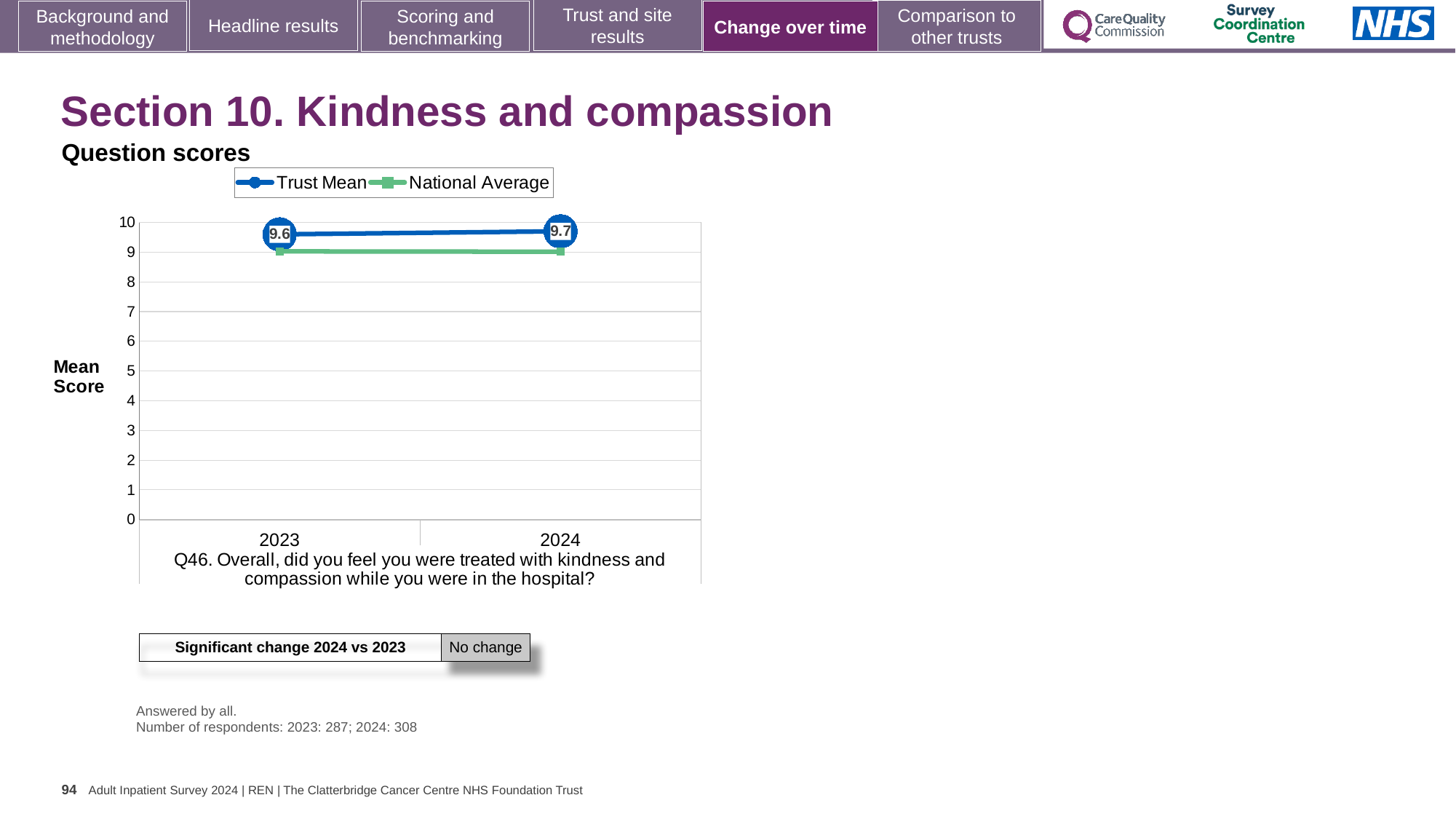
By how much did the Trust Mean change from 2023 to 2024? 0.1 Is the National Average value for 2023 greater or less than 8? greater Is the National Average value for 2024 greater or less than 10? less What is the Trust Mean score for 2024? 9.7 What is the label on the y axis of the chart? Mean Score Which year has the higher Trust Mean score, 2023 or 2024? 2024 How many series does the chart legend list? 2 Does the Trust Mean rise or fall from 2023 to 2024? Rise What kind of chart is shown on the slide? Line chart What is the Trust Mean score for 2023? 9.6 In 2024, which series is higher, Trust Mean or National Average? Trust Mean How many years are shown on the x axis of the chart? 2